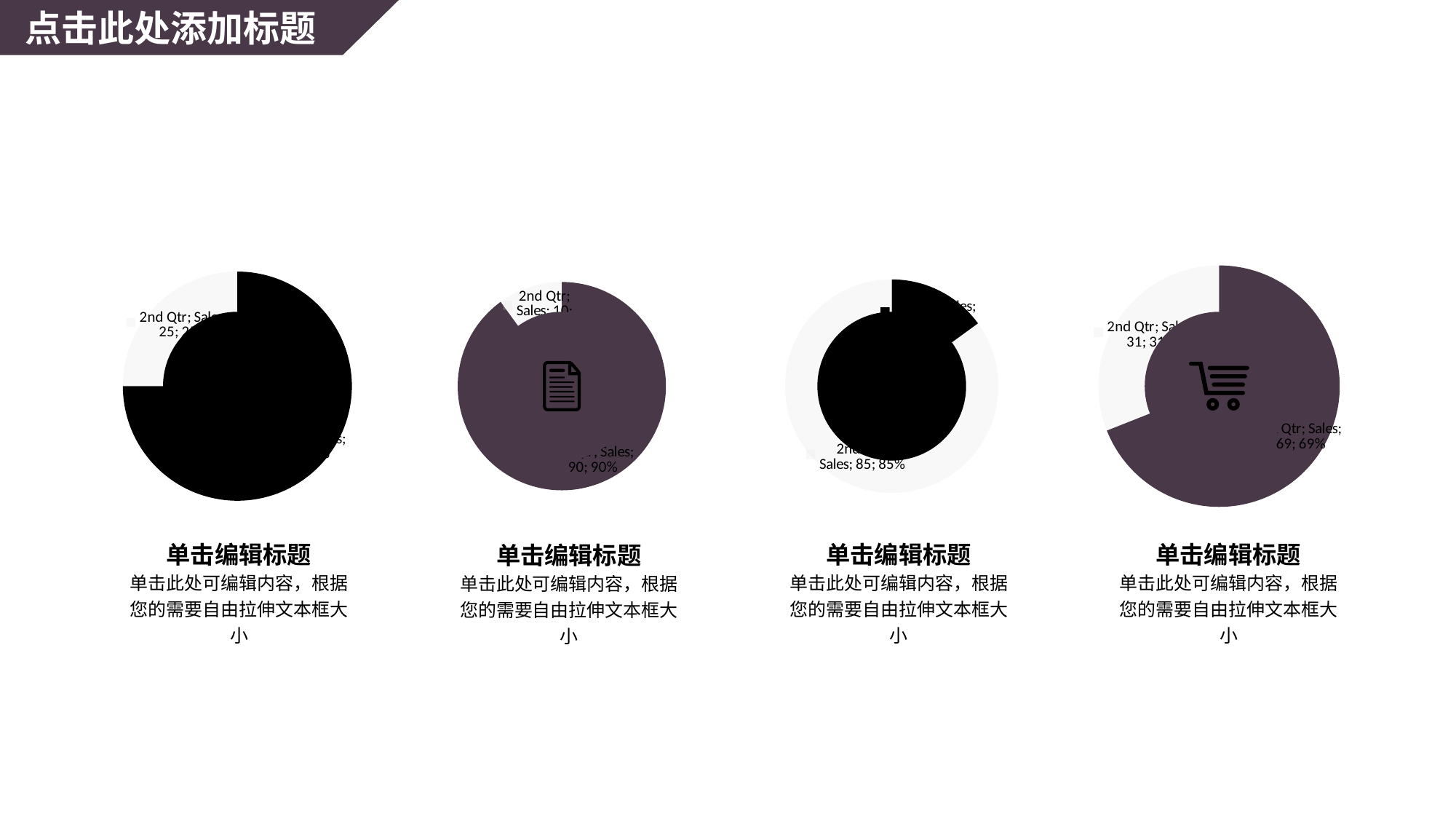
In the second chart from the left, which slice is larger, the dark one or the light one? the dark one In the rightmost chart, which slice is larger, the dark one or the light one? the dark one In the third chart from the left, what percentage is printed on the visible data label? 85% In the rightmost chart, what percentage is printed on the data label of the large dark slice? 69% In the second chart from the left, what percentage is printed on the data label of the large dark slice? 90% What series name appears in the data labels of the rightmost chart? Sales In the rightmost chart, what value is shown for the 2nd Qtr slice? 31 What icon is shown in the centre of the rightmost chart? a shopping cart In the leftmost chart, what value is shown for the 2nd Qtr slice? 25 What kind of chart is the leftmost chart on the slide? pie chart How many slices does the rightmost pie chart have? 2